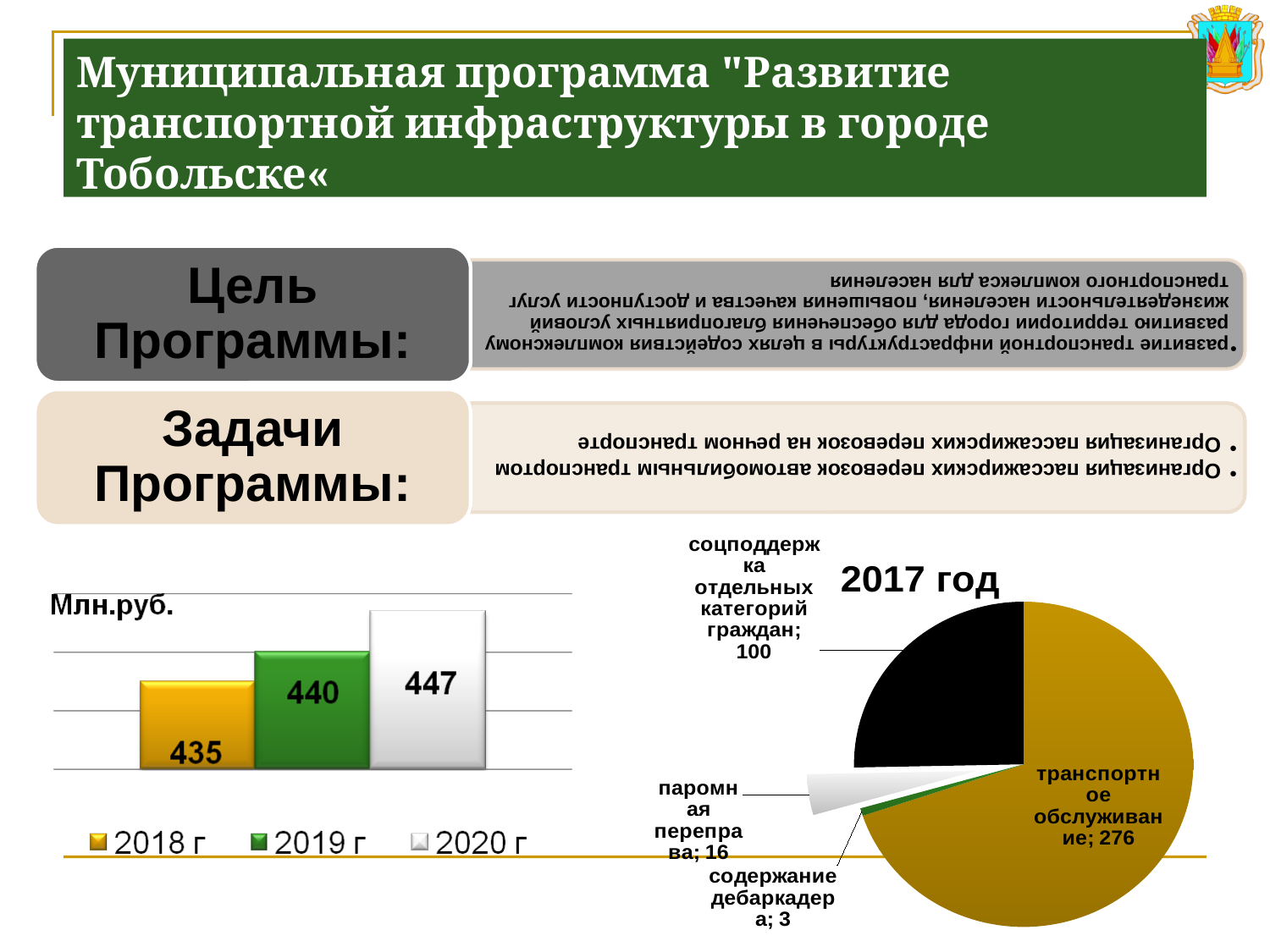
On the bar chart labelled Млн.руб., do the values rise or fall from 2018 г to 2020 г? rise On the pie chart titled 2017 год, what is the value for паромная переправа? 16 On the bar chart labelled Млн.руб., what is the value for 2020 г? 447 On the bar chart labelled Млн.руб., what is the value for 2018 г? 435 On the bar chart labelled Млн.руб., what is the difference between the values for 2020 г and 2018 г? 12 On the bar chart labelled Млн.руб., how many series does the legend list? 3 On the pie chart titled 2017 год, how many slices are there? 4 What kind of chart is the chart labelled Млн.руб. on the left? bar chart On the bar chart labelled Млн.руб., which year has the lowest value? 2018 г On the bar chart labelled Млн.руб., which year has the highest value? 2020 г On the pie chart titled 2017 год, which category has the smallest slice? содержание дебаркадера On the pie chart titled 2017 год, what is the value for транспортное обслуживание? 276